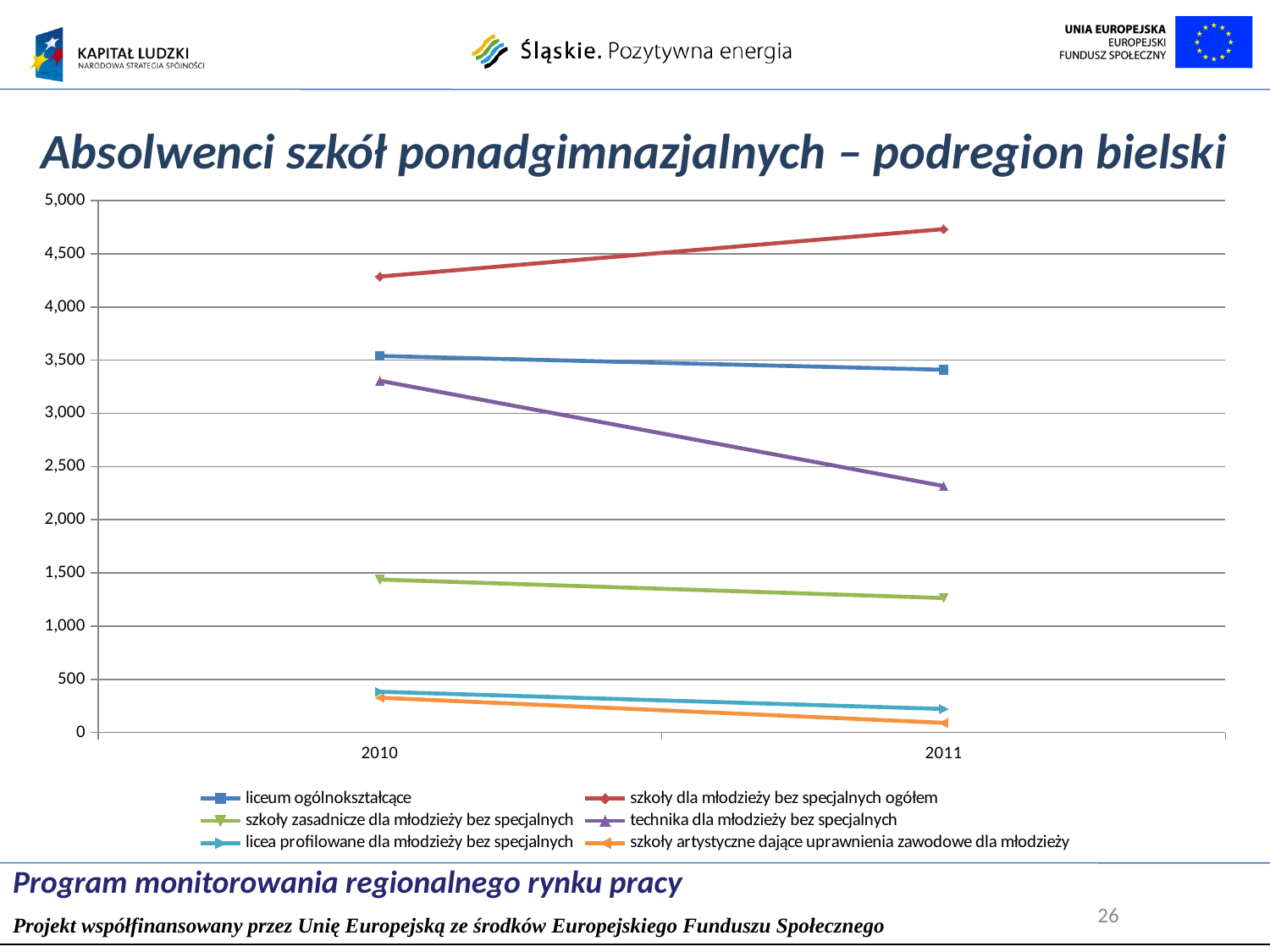
Which series has the highest value in 2011? szkoły dla młodzieży bez specjalnych ogółem How many series does the legend list? 6 Is the value for 'technika dla młodzieży bez specjalnych' in 2011 greater or less than 2,500? less Is the value for 'szkoły dla młodzieży bez specjalnych ogółem' in 2011 greater or less than 4,500? greater Is the value for 'szkoły artystyczne dające uprawnienia zawodowe dla młodzieży' in 2011 greater or less than 500? less What is the title of the chart? Absolwenci szkół ponadgimnazjalnych – podregion bielski How many years are shown on the x axis? 2 In 2011, which is larger: 'liceum ogólnokształcące' or 'technika dla młodzieży bez specjalnych'? liceum ogólnokształcące Does the value for 'technika dla młodzieży bez specjalnych' rise or fall from 2010 to 2011? fall Does the value for 'szkoły dla młodzieży bez specjalnych ogółem' rise or fall from 2010 to 2011? rise What type of chart is shown on the slide? line chart